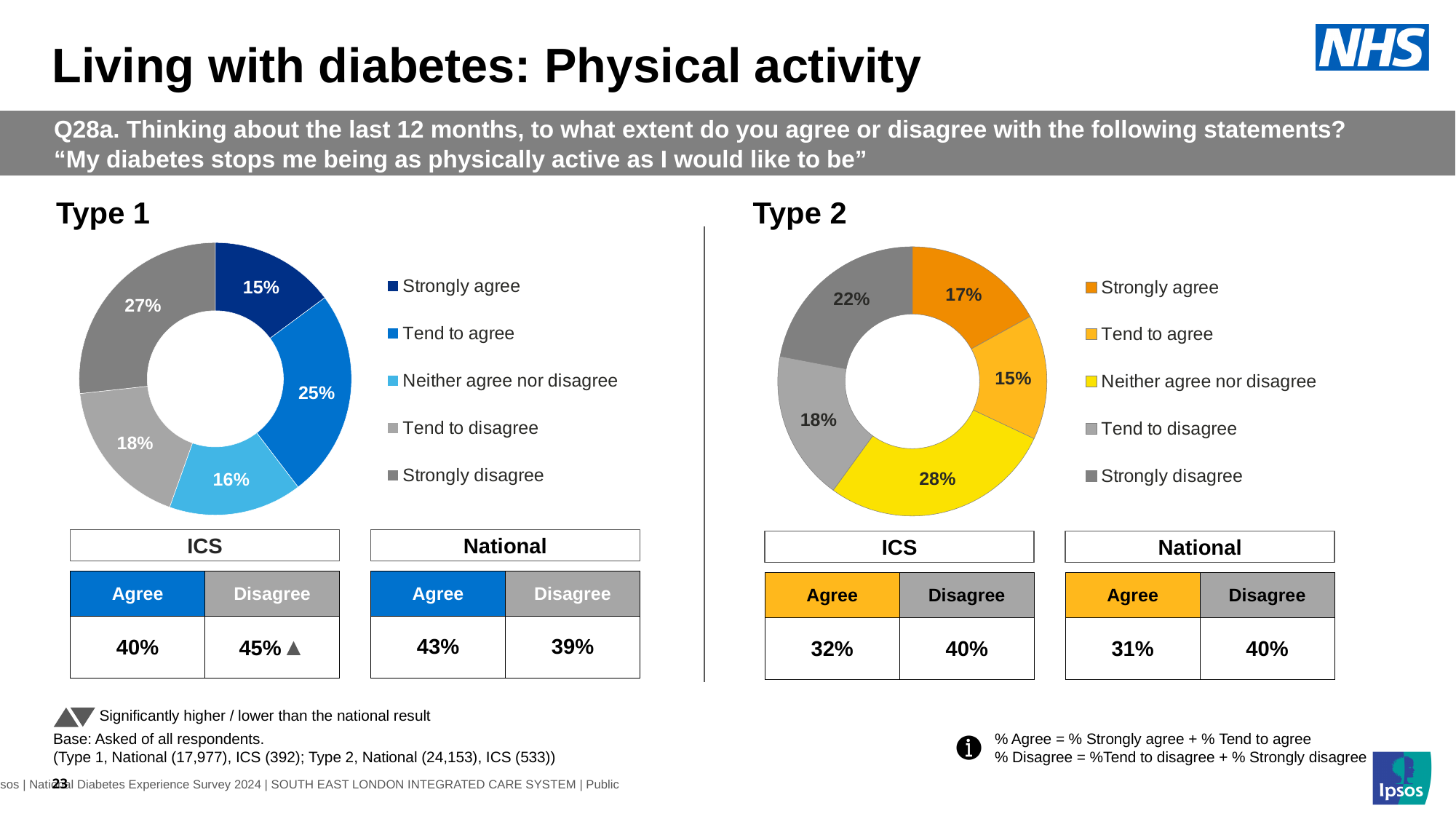
In the Type 1 chart, what colour is the 'Strongly agree' segment? Dark blue In the Type 1 chart, what is the combined share of 'Strongly agree' and 'Tend to agree'? 40% In the Type 2 chart, what percentage of respondents said 'Tend to disagree'? 18% How many entries does the legend of the Type 2 chart list? 5 In the Type 1 chart, which response category has the largest share? Strongly disagree How many response categories are shown in the Type 1 chart? 5 In the Type 2 chart, what percentage of respondents said 'Neither agree nor disagree'? 28% In the Type 2 chart, which is larger: 'Strongly disagree' or 'Strongly agree'? Strongly disagree What type of chart is used for the Type 2 results? Donut (pie) chart In the Type 2 chart, which response category has the smallest share? Tend to agree In the Type 1 chart, what is the difference between the 'Strongly disagree' and 'Strongly agree' shares? 12 percentage points In the Type 1 chart, what percentage of respondents said 'Strongly agree'? 15%